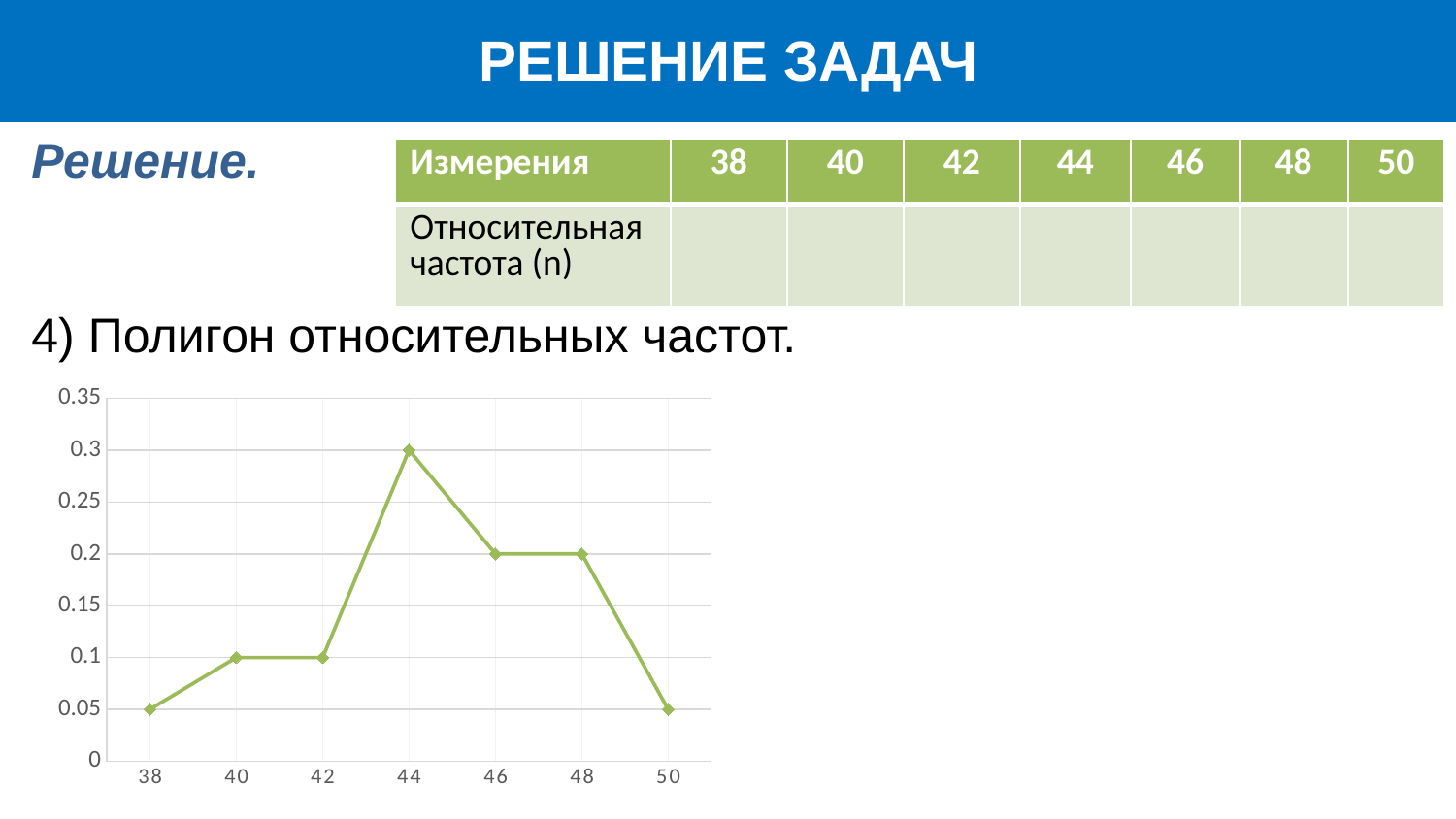
What is the relative frequency value plotted for measurement 44? 0.3 What is the difference between the plotted values for measurements 40 and 38? 0.05 Is the plotted value for measurement 48 greater or less than 0.15? greater What is the highest value shown on the vertical axis? 0.35 What is the relative frequency value plotted for measurement 38? 0.05 Which measurement has a higher plotted value, 40 or 44? 44 What is the relative frequency value plotted for measurement 46? 0.2 What kind of chart is shown on the slide? line chart What is the difference between the plotted values for measurements 44 and 46? 0.1 How many data points are plotted on the line chart? 7 Which measurement has the highest plotted value? 44 Does the line rise or fall between measurements 44 and 50? fall